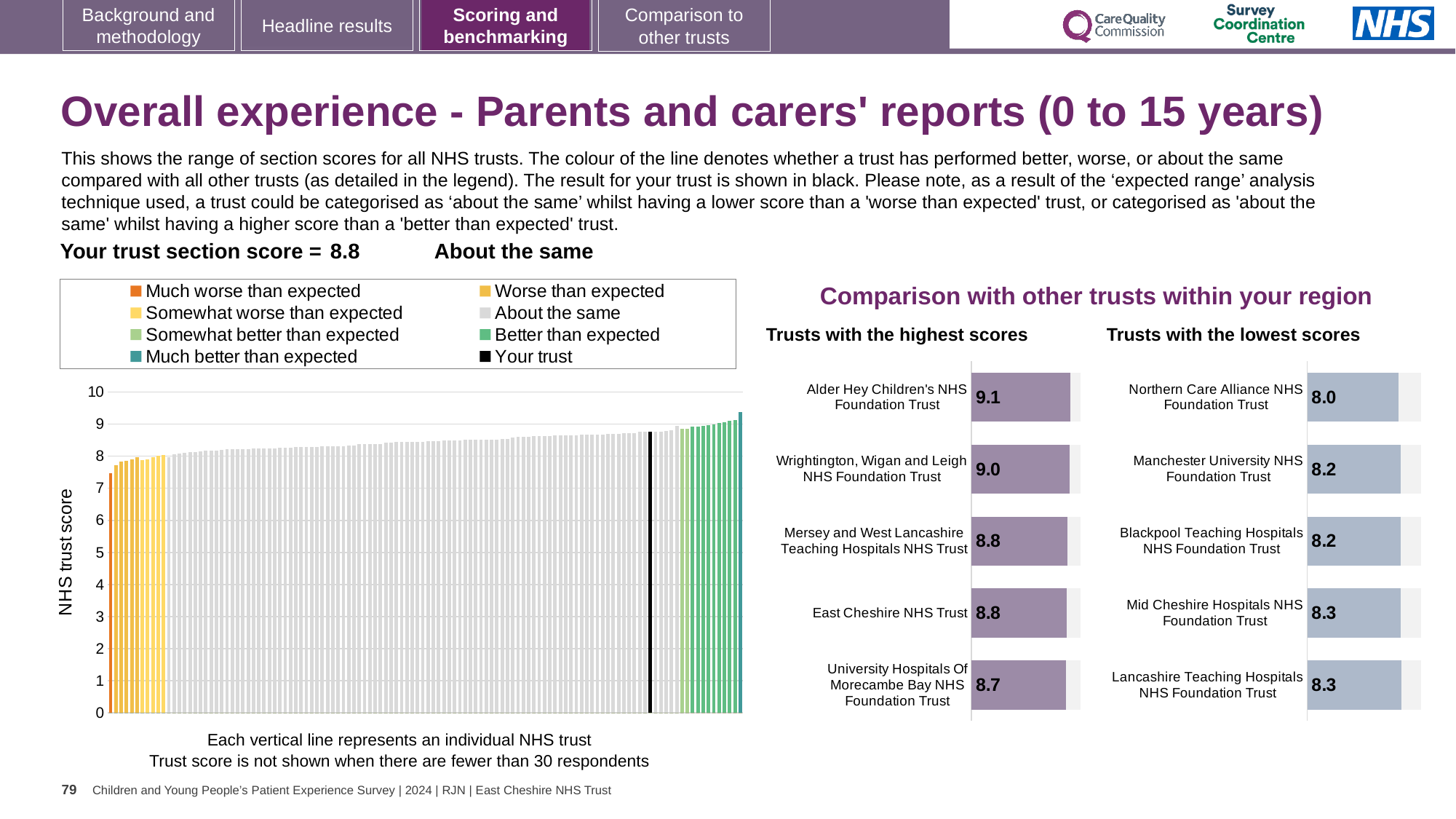
In the 'Trusts with the lowest scores' chart, which has the larger score: Northern Care Alliance NHS Foundation Trust or Mid Cheshire Hospitals NHS Foundation Trust? Mid Cheshire Hospitals NHS Foundation Trust How many trusts are shown in the 'Trusts with the lowest scores' chart? 5 In the 'Trusts with the highest scores' chart, what is the score for Alder Hey Children's NHS Foundation Trust? 9.1 In the 'Trusts with the highest scores' chart, which trust has the lowest score? University Hospitals Of Morecambe Bay NHS Foundation Trust In the 'NHS trust score' chart on the left, is the value of the leftmost (orange) bar greater or less than 8? less What kind of chart is the 'NHS trust score' chart on the left of the slide? Bar chart In the 'Trusts with the highest scores' chart, what is the difference between the scores of Alder Hey Children's NHS Foundation Trust and University Hospitals Of Morecambe Bay NHS Foundation Trust? 0.4 In the 'Trusts with the highest scores' chart, which trust has the highest score? Alder Hey Children's NHS Foundation Trust In the 'Trusts with the lowest scores' chart, which trust has the lowest score? Northern Care Alliance NHS Foundation Trust How many entries does the legend of the 'NHS trust score' chart list? 8 In the 'NHS trust score' chart on the left, do the bar heights rise or fall from left to right? Rise In the 'Trusts with the lowest scores' chart, what is the score for Northern Care Alliance NHS Foundation Trust? 8.0